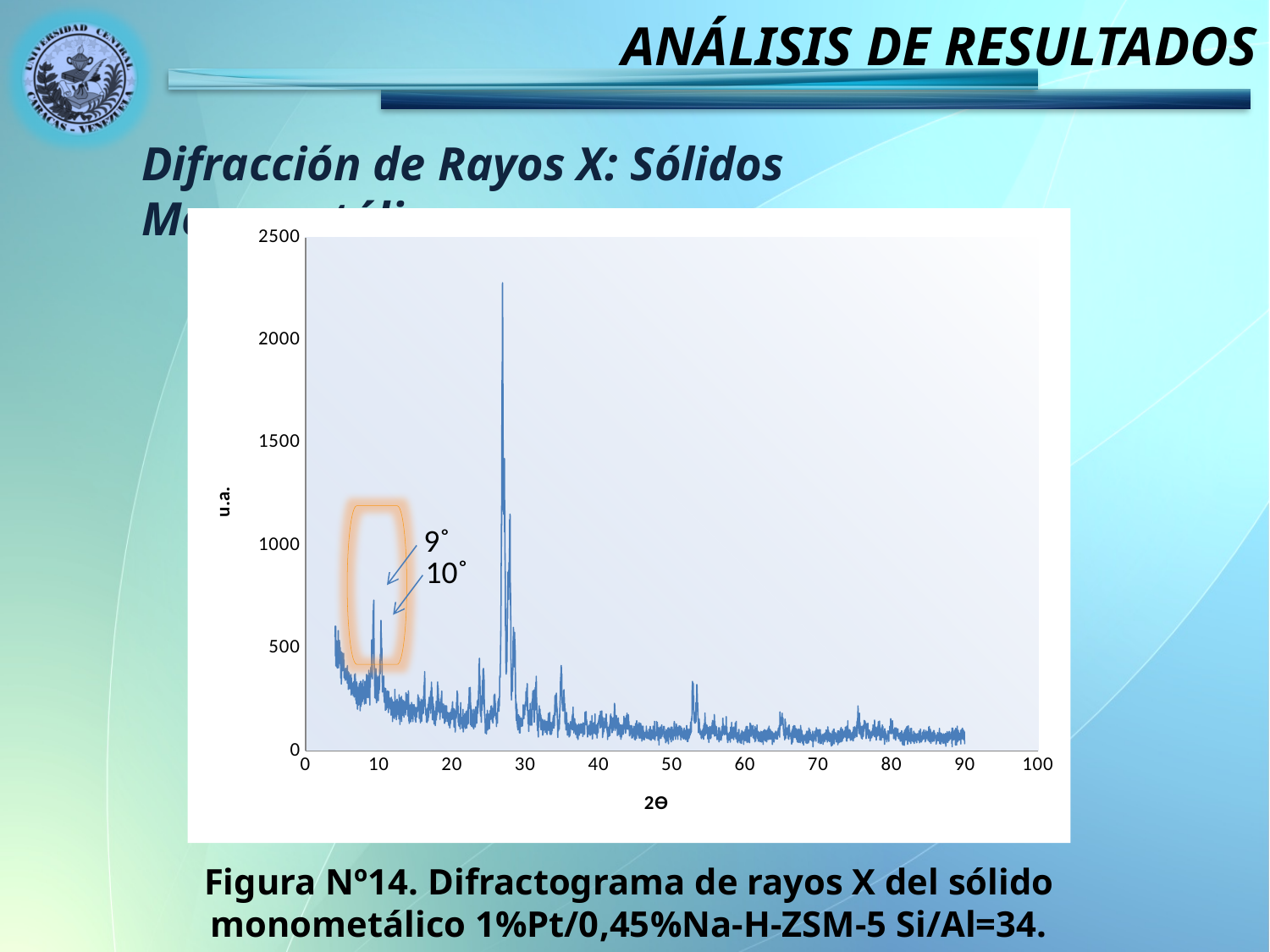
Is the value of the tallest peak in the diffractogram greater or less than 2500? less What kind of chart is shown on the slide? line chart Is the value of the tallest peak in the diffractogram greater or less than 2000? greater Which is larger, the peak marked 9° or the tallest peak between 2Θ = 20 and 30? the tallest peak between 20 and 30 Between 2Θ = 30 and 2Θ = 90, does the signal generally rise or fall along the x axis? fall Is the signal at 2Θ = 80 greater or less than 500? less What is the label of the x axis of the chart? 2Θ What is the label of the y axis of the chart? u.a. What is the maximum value shown on the y axis of the chart? 2500